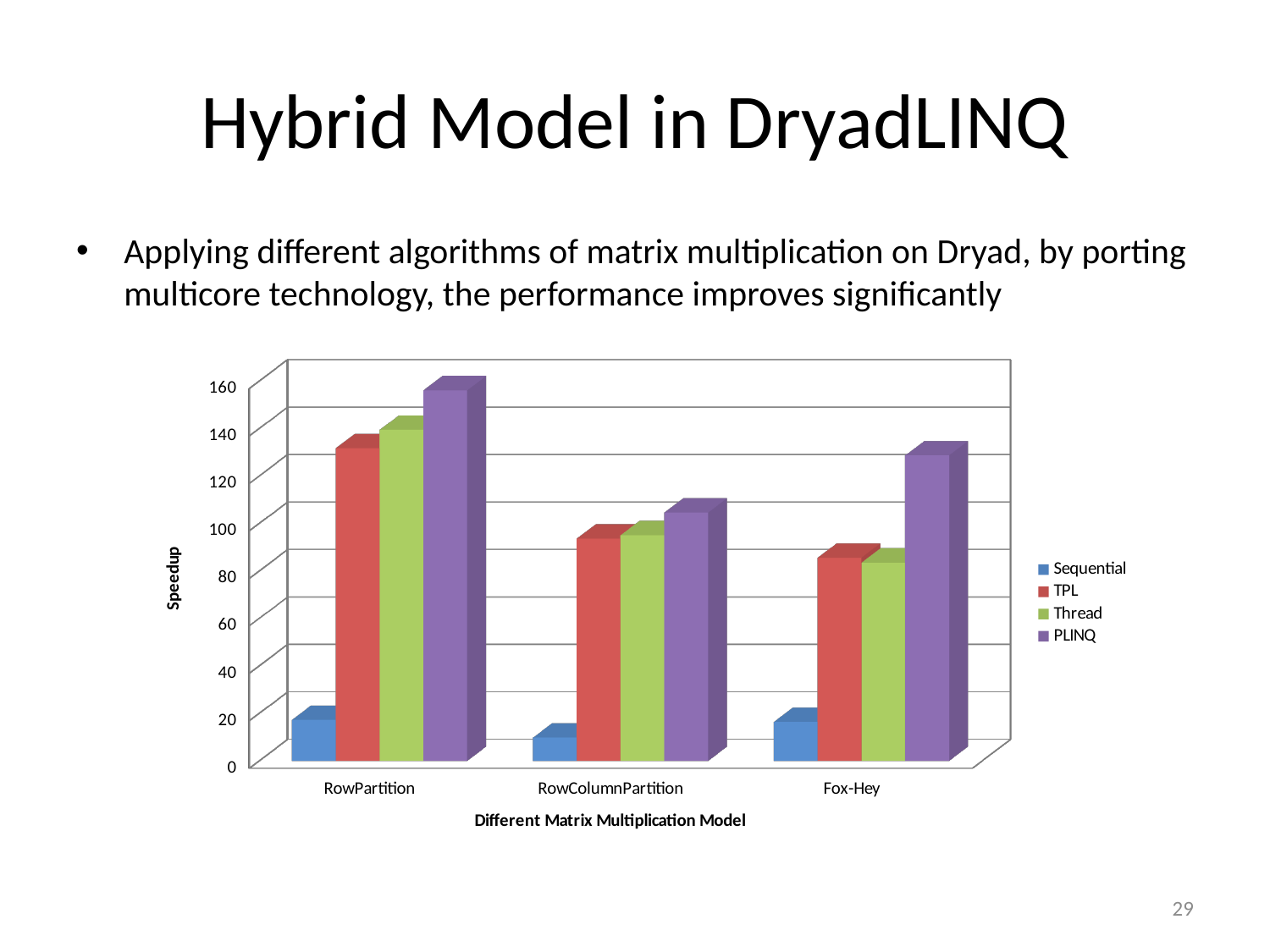
How many series does the legend list? 4 Is the PLINQ speedup for RowPartition greater or less than 140? greater What kind of chart is shown on the slide? bar chart What is the title of the vertical axis? Speedup Which series has the lowest speedup in every category? Sequential Which series has the highest speedup for RowPartition? PLINQ Is the TPL speedup for Fox-Hey greater or less than 100? less For which matrix multiplication model is the PLINQ speedup highest? RowPartition Is the PLINQ speedup for RowColumnPartition greater or less than 120? less For Fox-Hey, which is larger: the PLINQ speedup or the TPL speedup? PLINQ How many matrix multiplication models (categories) are shown on the x axis? 3